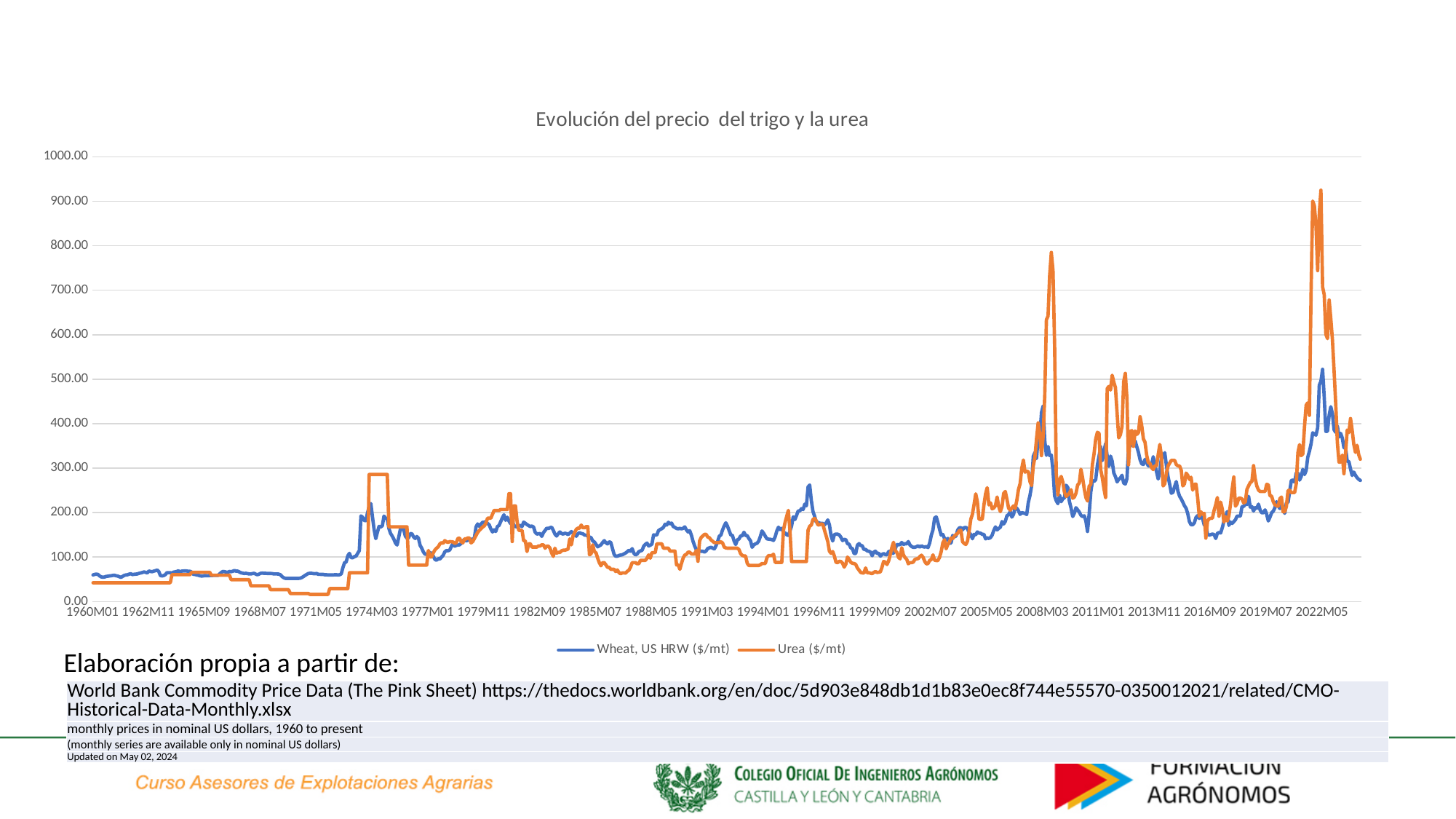
Is the peak value of Urea ($/mt) around 2008 greater or less than 700? greater Which colour is used for the Urea ($/mt) series? orange How many series does the legend list? 2 Is the value of Urea ($/mt) around 1971M05 greater or less than 100? less Is the peak value of Wheat, US HRW ($/mt) around 2022 greater or less than 400? greater What kind of chart is shown on the slide? line chart Which series has the higher peak around 2008: Wheat, US HRW ($/mt) or Urea ($/mt)? Urea ($/mt) Which series reaches the highest value anywhere on the chart? Urea ($/mt) Overall, do the prices rise or fall from 1960 to 2022 along the x axis? rise What is the title of the chart? Evolución del precio del trigo y la urea